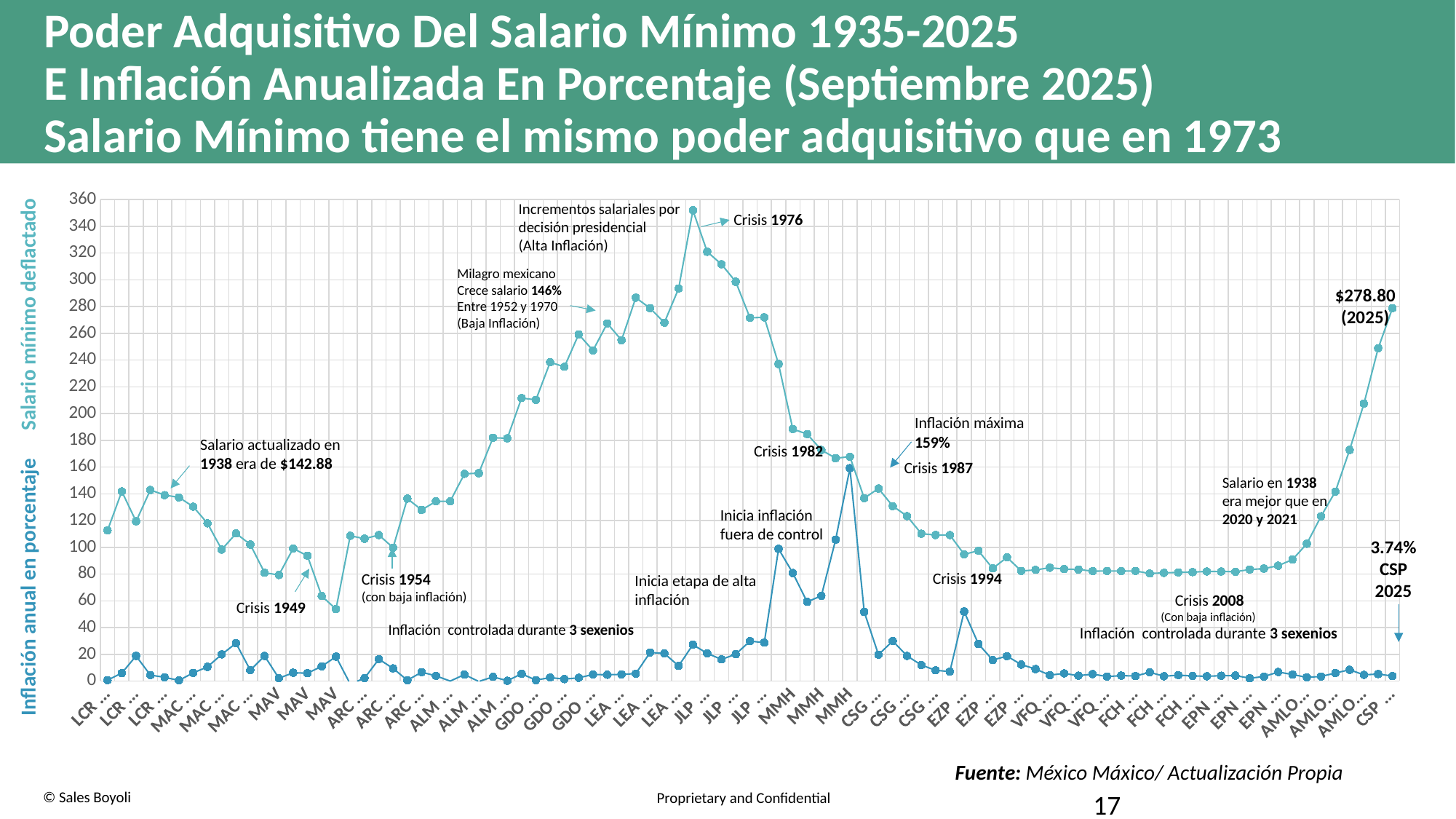
Is the peak value of the salario mínimo deflactado at Crisis 1976 greater or less than 340? greater According to the annotation, what was the salario actualizado in 1938? $142.88 From the 1976 peak through the 1990s, does the salario mínimo deflactado line rise or fall? fall What is the difference between the salario mínimo deflactado in 2025 ($278.80) and the salario actualizado in 1938 ($142.88)? $135.92 Is the salario mínimo deflactado during the VFQ and FCH periods greater or less than 100? less What kind of chart is shown on the slide? line chart According to the annotation, what is the value of the salario mínimo deflactado in 2025? $278.80 What is the maximum inflation value annotated on the chart (Inflación máxima)? 159% Which is larger: the salario mínimo deflactado in 2025 or the salario actualizado in 1938? 2025 What is the annualized inflation value annotated for CSP 2025? 3.74% During the AMLO and CSP periods at the right of the chart, does the salario mínimo deflactado line rise or fall? rise What source is cited for the chart (Fuente)? México Máxico/ Actualización Propia